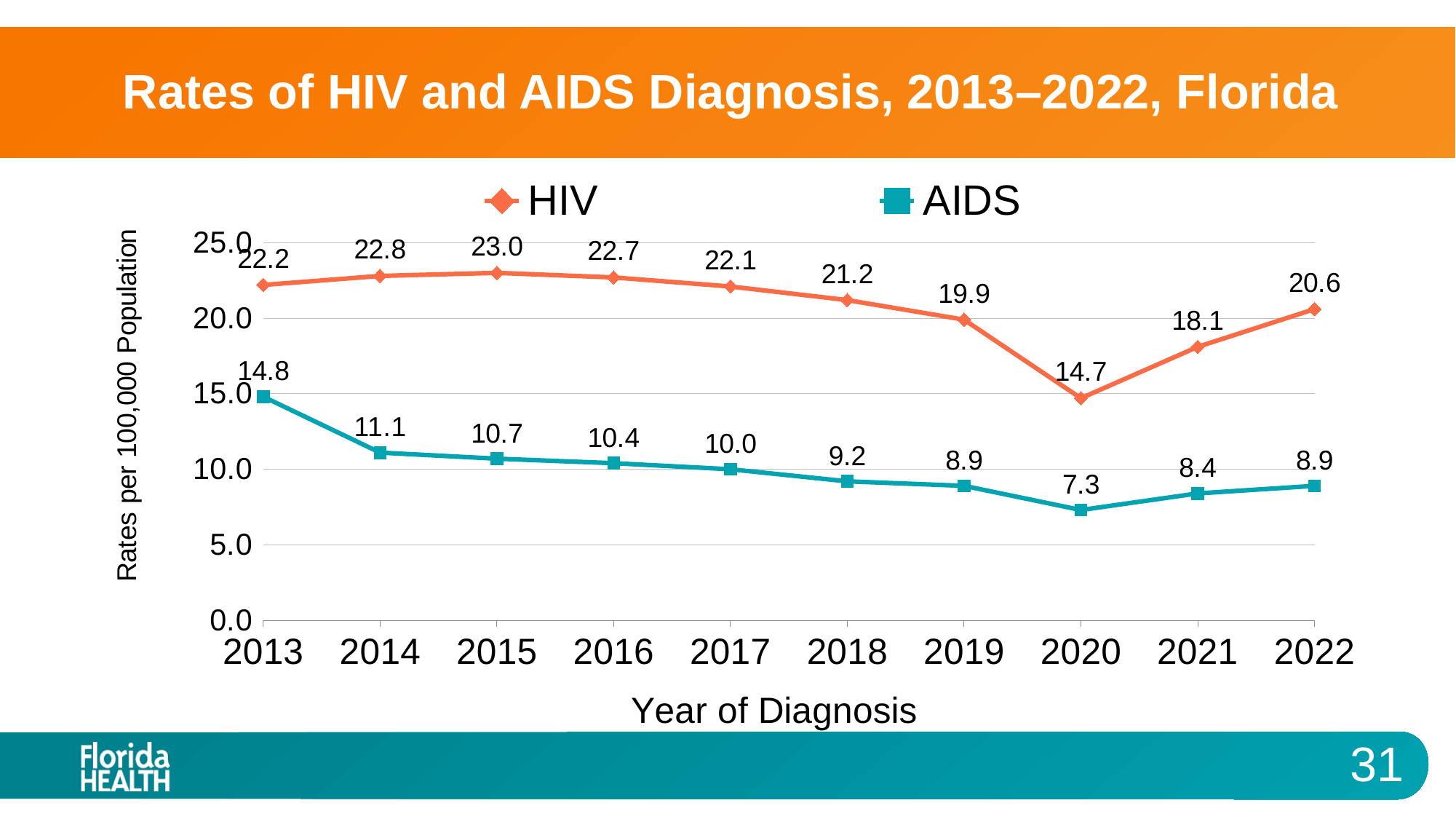
What is the difference between the HIV and AIDS diagnosis rates in 2022? 11.7 Which series had the higher rate in 2019, HIV or AIDS? HIV How many years are shown on the x axis? 10 What was the HIV diagnosis rate in 2015? 23.0 In which year was the AIDS diagnosis rate highest? 2013 Is the HIV diagnosis rate for 2021 greater or less than 20.0? less In which year was the HIV diagnosis rate lowest? 2020 What kind of chart is shown on the slide? line chart What is the label of the y axis? Rates per 100,000 Population Did the AIDS diagnosis rate rise or fall from 2013 to 2020? fall How many series does the legend list? 2 What was the AIDS diagnosis rate in 2020? 7.3